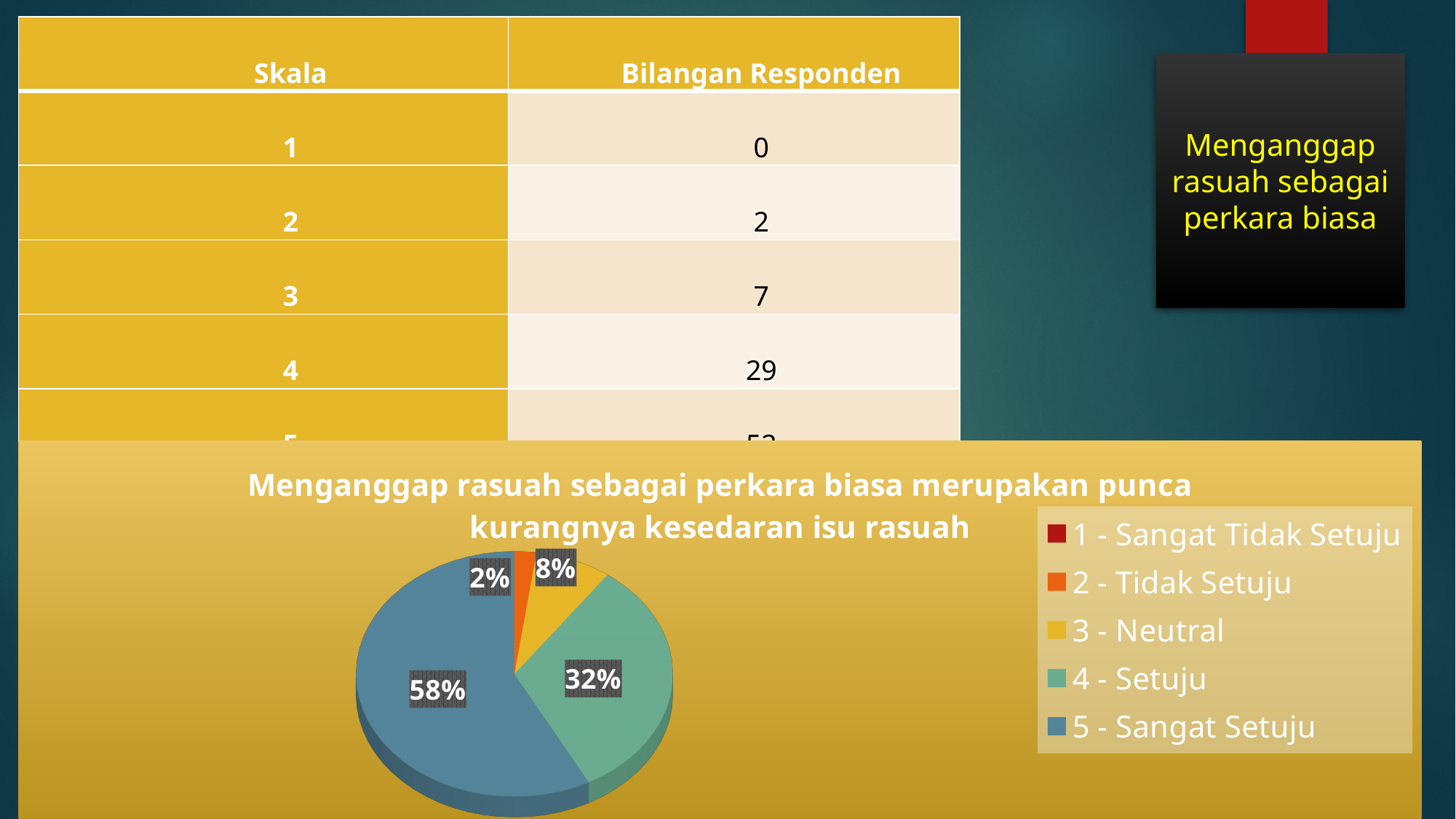
What is the title of the pie chart? Menganggap rasuah sebagai perkara biasa merupakan punca kurangnya kesedaran isu rasuah Which slice is larger, 2 - Tidak Setuju or 3 - Neutral? 3 - Neutral Which category has the largest slice of the pie chart? 5 - Sangat Setuju Which slice is larger, 3 - Neutral or 4 - Setuju? 4 - Setuju What share of the pie chart is labelled for 3 - Neutral? 8% What share of the pie chart is labelled for 4 - Setuju? 32% What type of chart is shown on the slide? Pie chart What colour is the 5 - Sangat Setuju slice in the pie chart? Blue What share of the pie chart is labelled for 5 - Sangat Setuju? 58% What is the difference in percentage points between the 5 - Sangat Setuju slice and the 4 - Setuju slice? 26 percentage points What share of the pie chart is labelled for 2 - Tidak Setuju? 2% How many entries does the chart legend list? 5